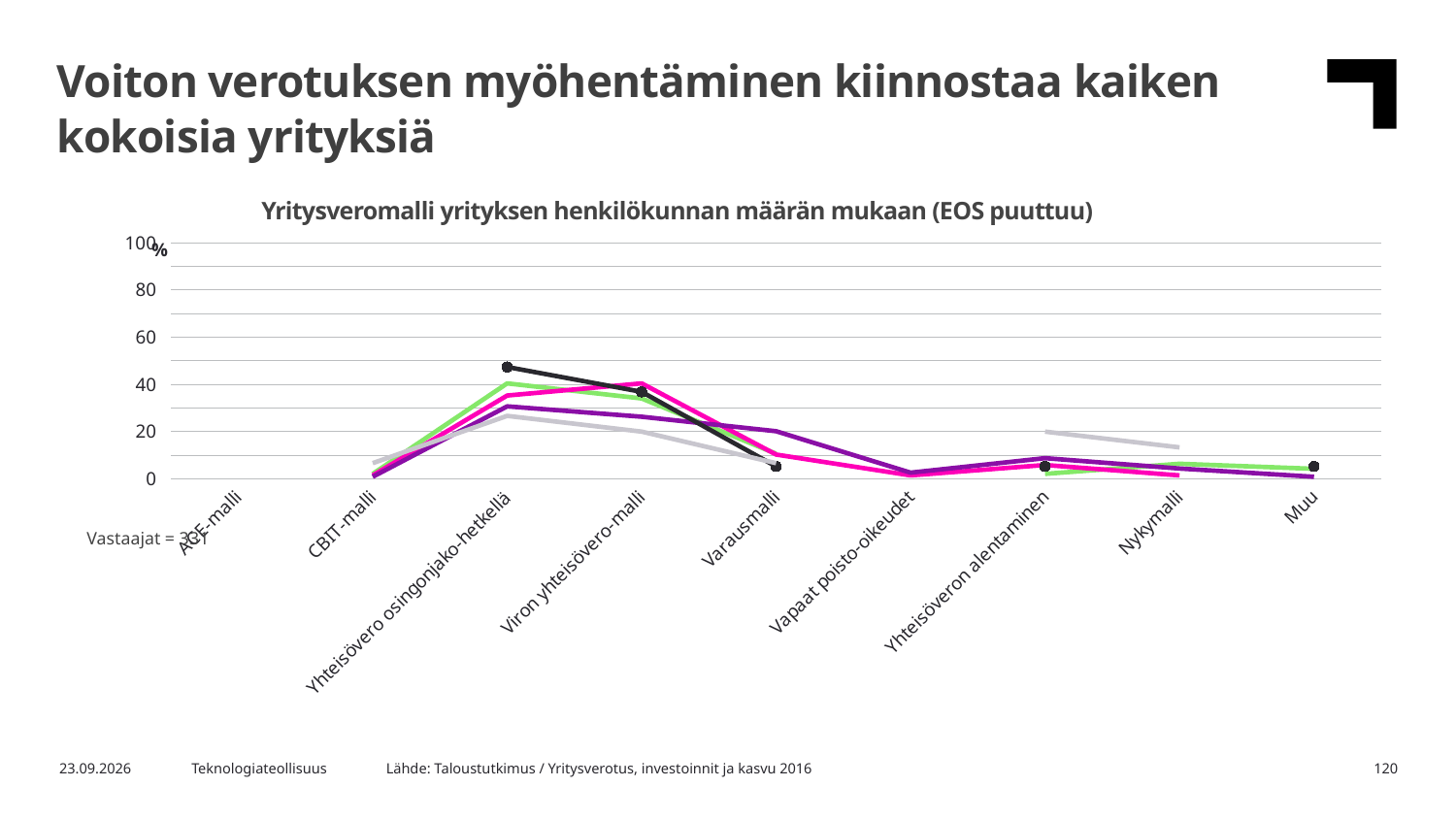
Is the value of the black line for Yhteisövero osingonjako-hetkellä greater or less than 40? greater Which category has the highest values across the lines in the chart? Yhteisövero osingonjako-hetkellä Is the value of the black line for Varausmalli greater or less than 20? less How many categories are shown along the x axis of the chart? 9 Are all the lines for Vapaat poisto-oikeudet greater or less than 20? less At which category does the black line reach its highest value? Yhteisövero osingonjako-hetkellä What is the highest value shown on the y axis of the chart? 100 Do the lines rise or fall from Yhteisövero osingonjako-hetkellä to Vapaat poisto-oikeudet? fall For the black line, is the value higher at Yhteisövero osingonjako-hetkellä or at Varausmalli? Yhteisövero osingonjako-hetkellä What is the title of the chart? Yritysveromalli yrityksen henkilökunnan määrän mukaan (EOS puuttuu) What kind of chart is shown on the slide? Line chart